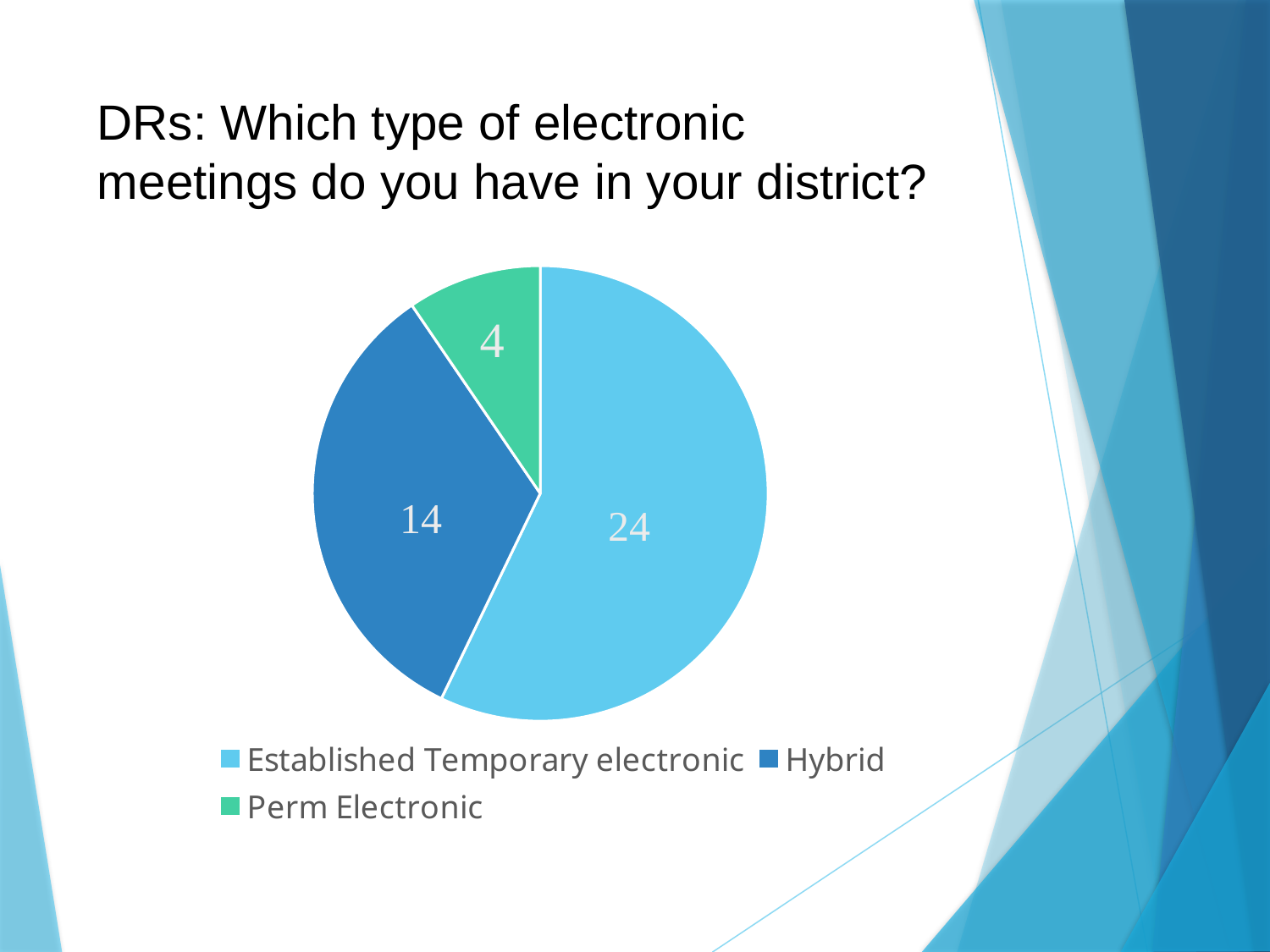
What is the value for Established Temporary electronic? 24 What is the difference between the values for Hybrid and Perm Electronic? 10 What is the value for Hybrid? 14 What is the value for Perm Electronic? 4 What is the title of the slide containing the pie chart? DRs: Which type of electronic meetings do you have in your district? Which is larger, the value for Hybrid or the value for Perm Electronic? Hybrid What is the difference between the values for Established Temporary electronic and Hybrid? 10 Which category has the smallest slice of the pie? Perm Electronic What is the total of all the slices in the pie chart? 42 Which category has the largest slice of the pie? Established Temporary electronic How many categories does the pie chart show? 3 What type of chart is shown on the slide? Pie chart